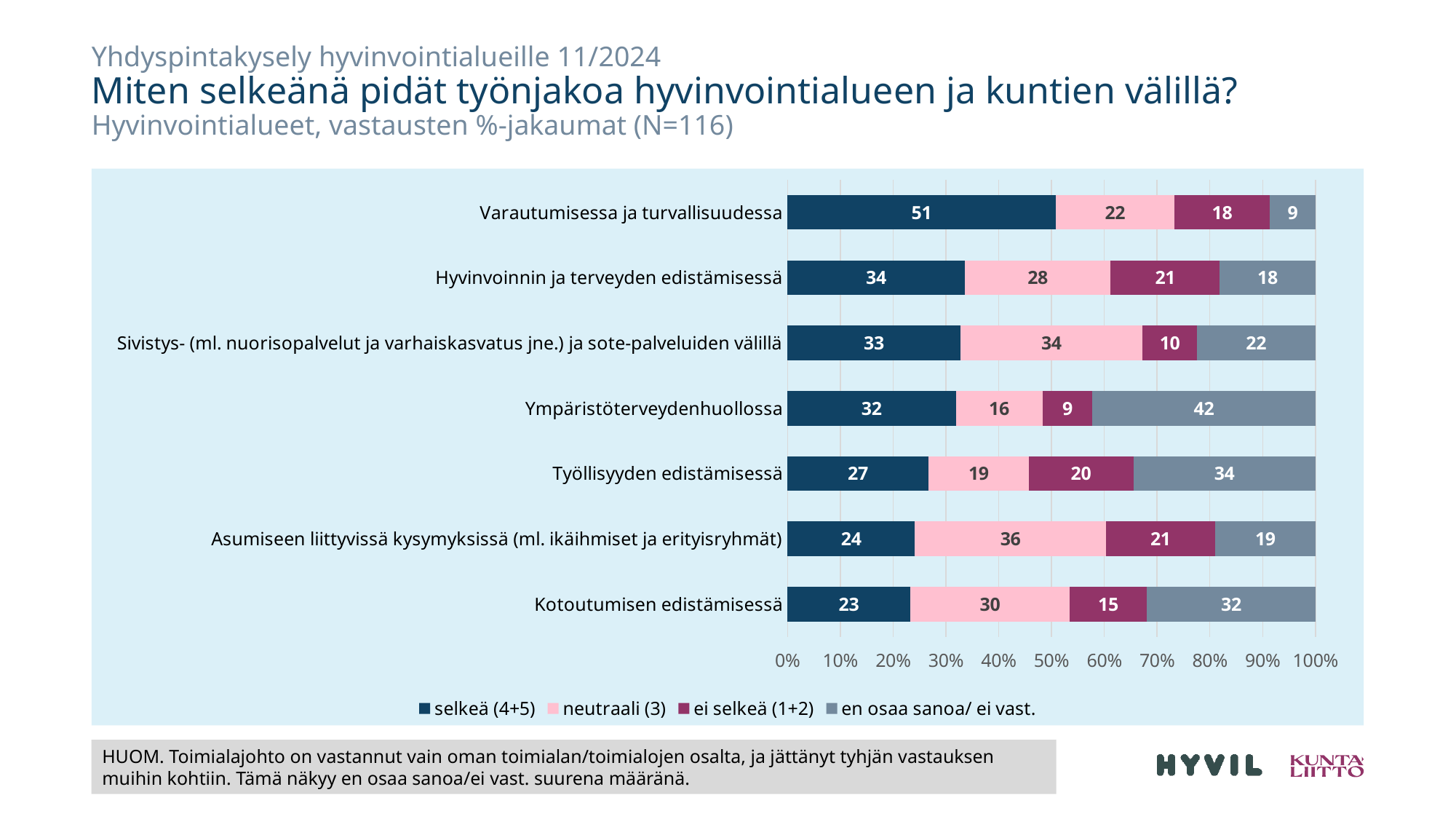
What is the total of the stacked bar for "Varautumisessa ja turvallisuudessa"? 100 Which category has the highest "selkeä (4+5)" value? Varautumisessa ja turvallisuudessa Which has a larger "ei selkeä (1+2)" value: "Hyvinvoinnin ja terveyden edistämisessä" or "Sivistys- (ml. nuorisopalvelut ja varhaiskasvatus jne.) ja sote-palveluiden välillä"? Hyvinvoinnin ja terveyden edistämisessä What is the "neutraali (3)" value for "Kotoutumisen edistämisessä"? 30 What percentage of respondents answered "selkeä (4+5)" for "Varautumisessa ja turvallisuudessa"? 51 How many series does the legend list? 4 Which category has the highest "en osaa sanoa/ ei vast." value? Ympäristöterveydenhuollossa What kind of chart is shown on the slide? Stacked bar chart Which category has the lowest "selkeä (4+5)" value? Kotoutumisen edistämisessä How many categories are shown in the chart? 7 What is the difference between the "neutraali (3)" values for "Asumiseen liittyvissä kysymyksissä (ml. ikäihmiset ja erityisryhmät)" and "Ympäristöterveydenhuollossa"? 20 What is the "en osaa sanoa/ ei vast." value for "Ympäristöterveydenhuollossa"? 42